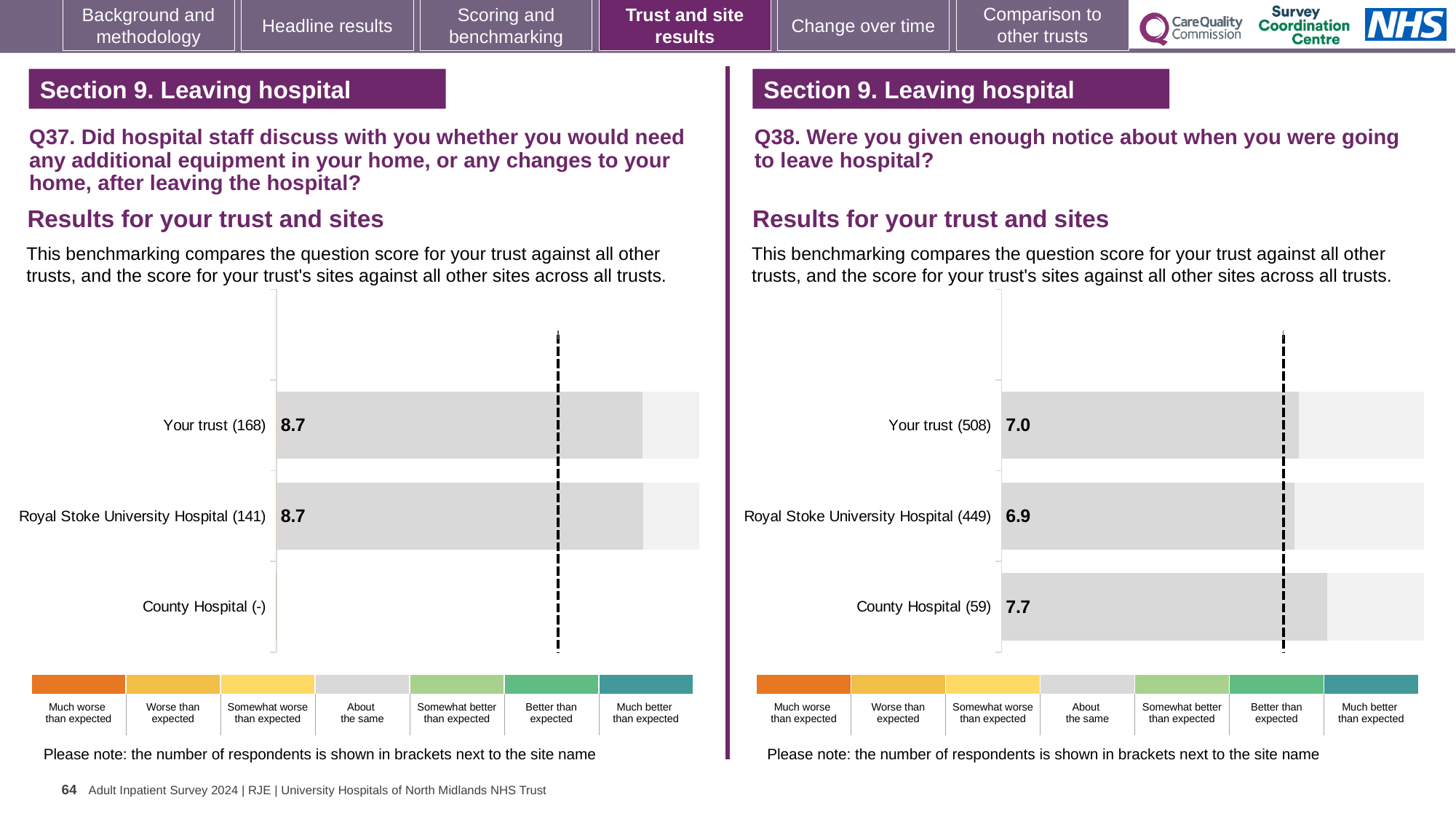
In the Q37 chart on the left, what is the score for Your trust? 8.7 In the Q37 chart on the left, what is the score for Royal Stoke University Hospital? 8.7 How many categories (trust and sites) are listed in the Q38 chart on the right? 3 In the Q38 chart on the right, what is the score for Your trust? 7.0 What kind of chart is used in the Q37 chart on the left? bar chart In the Q37 chart on the left, how many respondents are shown for Royal Stoke University Hospital? 141 In the Q38 chart on the right, what is the score for County Hospital? 7.7 In the Q38 chart on the right, which site or trust has the lowest score? Royal Stoke University Hospital In the Q38 chart on the right, what is the difference between the County Hospital score and the Royal Stoke University Hospital score? 0.8 In the Q38 chart on the right, how many respondents are shown for Your trust? 508 In the Q38 chart on the right, is the score for County Hospital larger or smaller than the score for Your trust? larger In the Q38 chart on the right, which site or trust has the highest score? County Hospital